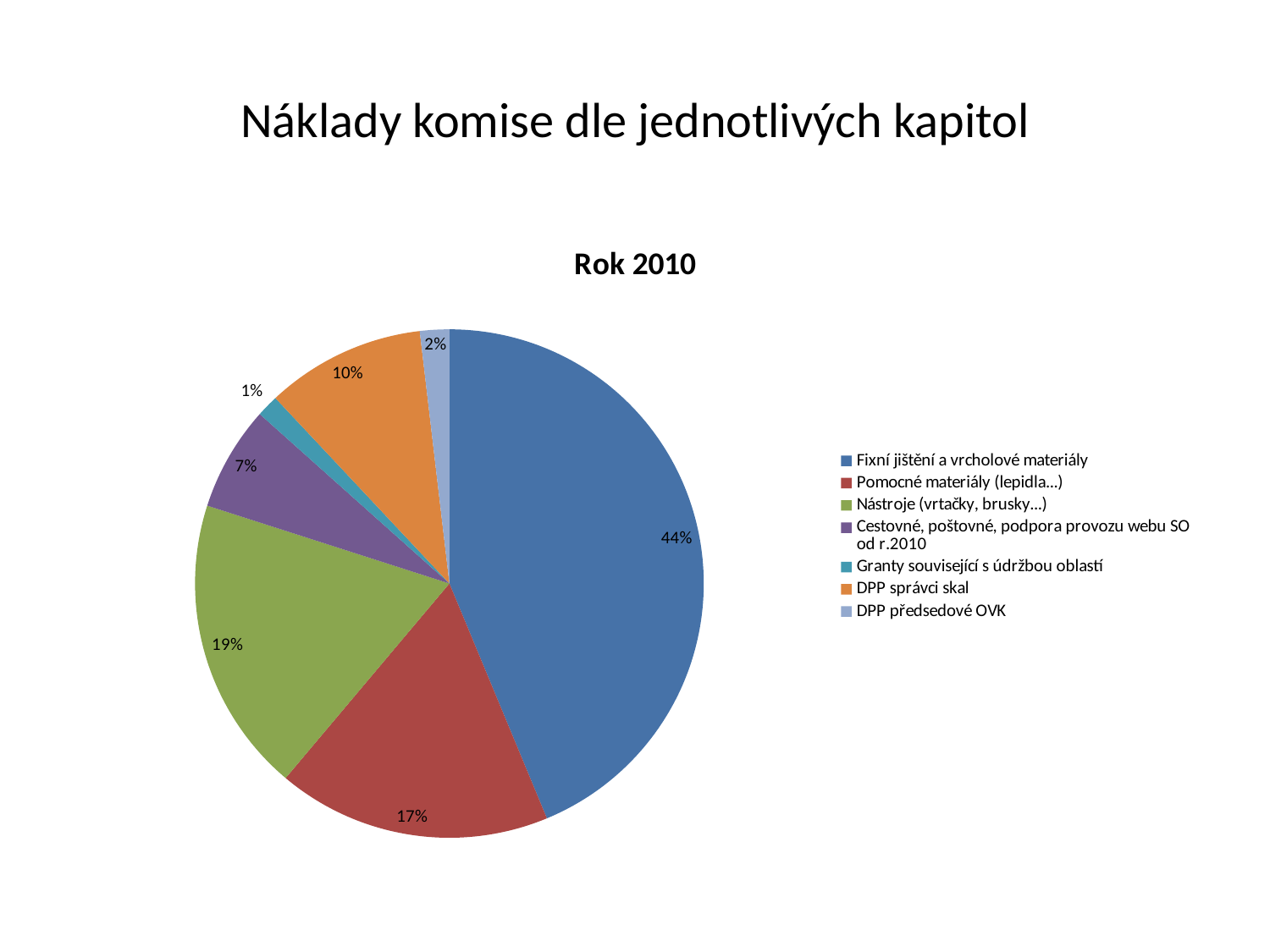
What share of the pie does 'Nástroje (vrtačky, brusky…)' have? 19% Which category has the smallest slice of the pie? Granty související s údržbou oblastí What share of the pie does 'Granty související s údržbou oblastí' have? 1% What kind of chart is shown on the slide? pie chart What is the difference in percentage points between 'Fixní jištění a vrcholové materiály' and 'Pomocné materiály (lepidla…)'? 27 What share of the pie does 'Fixní jištění a vrcholové materiály' have? 44% What is the title of the chart? Rok 2010 What share of the pie does 'DPP předsedové OVK' have? 2% Which category has the largest slice of the pie? Fixní jištění a vrcholové materiály How many categories does the legend list? 7 What share of the pie does 'DPP správci skal' have? 10% Which is larger: the slice for 'Nástroje (vrtačky, brusky…)' or the slice for 'Pomocné materiály (lepidla…)'? Nástroje (vrtačky, brusky…)